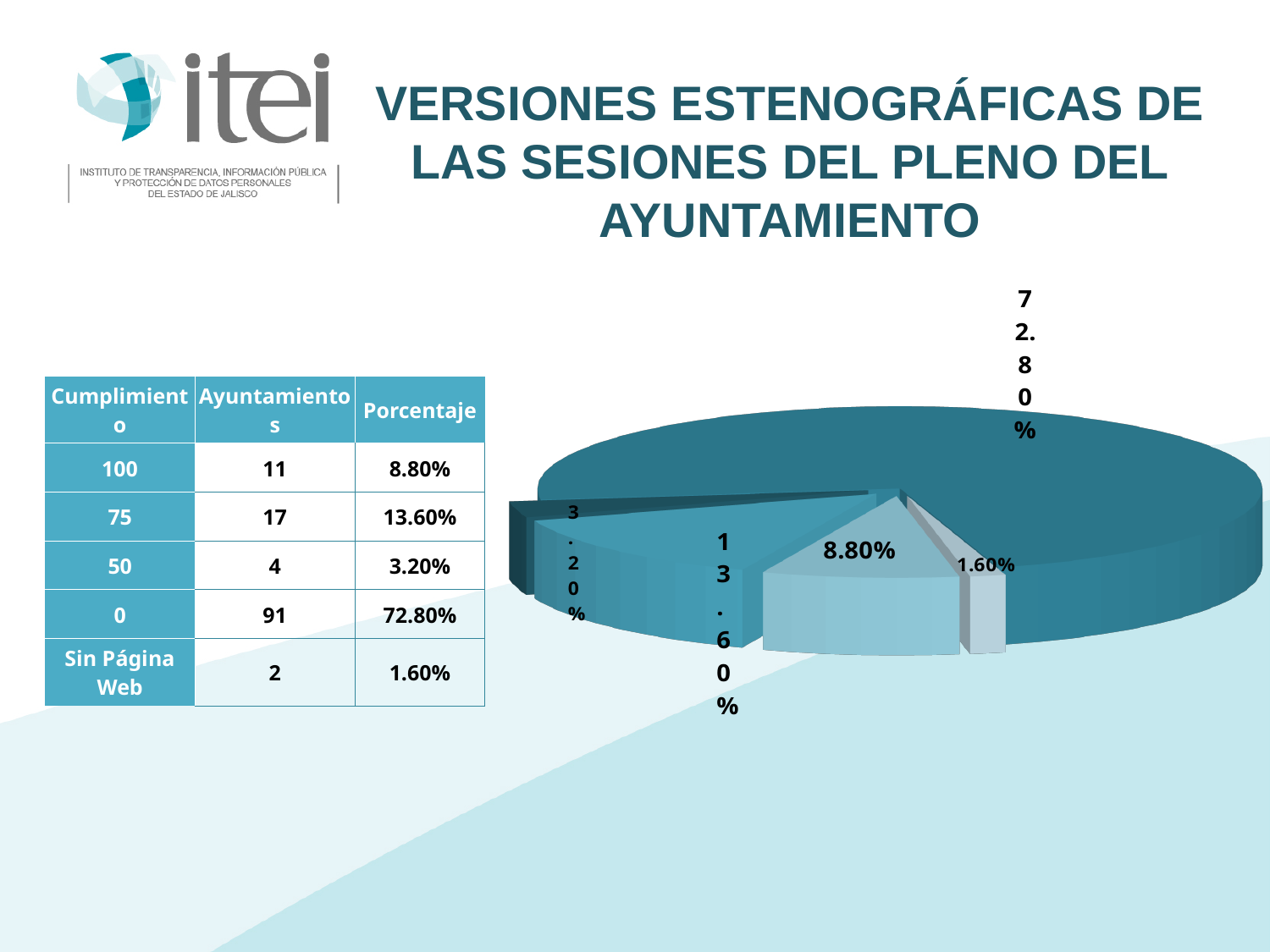
What do the five slice labels of the pie chart add up to? 100.00% What is the title shown above the chart on the slide? VERSIONES ESTENOGRÁFICAS DE LAS SESIONES DEL PLENO DEL AYUNTAMIENTO Which slice is larger, the one labelled 13.60% or the one labelled 8.80%? 13.60% What is the difference between the largest slice (72.80%) and the slice labelled 13.60%? 59.20% According to the table next to the pie chart, which Cumplimiento value corresponds to the 72.80% slice? 0 According to the table next to the pie chart, what share of the pie corresponds to 'Sin Página Web'? 1.60% How many slices does the pie chart have? 5 What is the difference between the slice labelled 8.80% and the slice labelled 3.20%? 5.60% Does the pie chart display a legend? No What is the data label of the largest slice in the pie chart? 72.80% What kind of chart is shown on the slide? pie chart What is the data label of the smallest slice in the pie chart? 1.60%